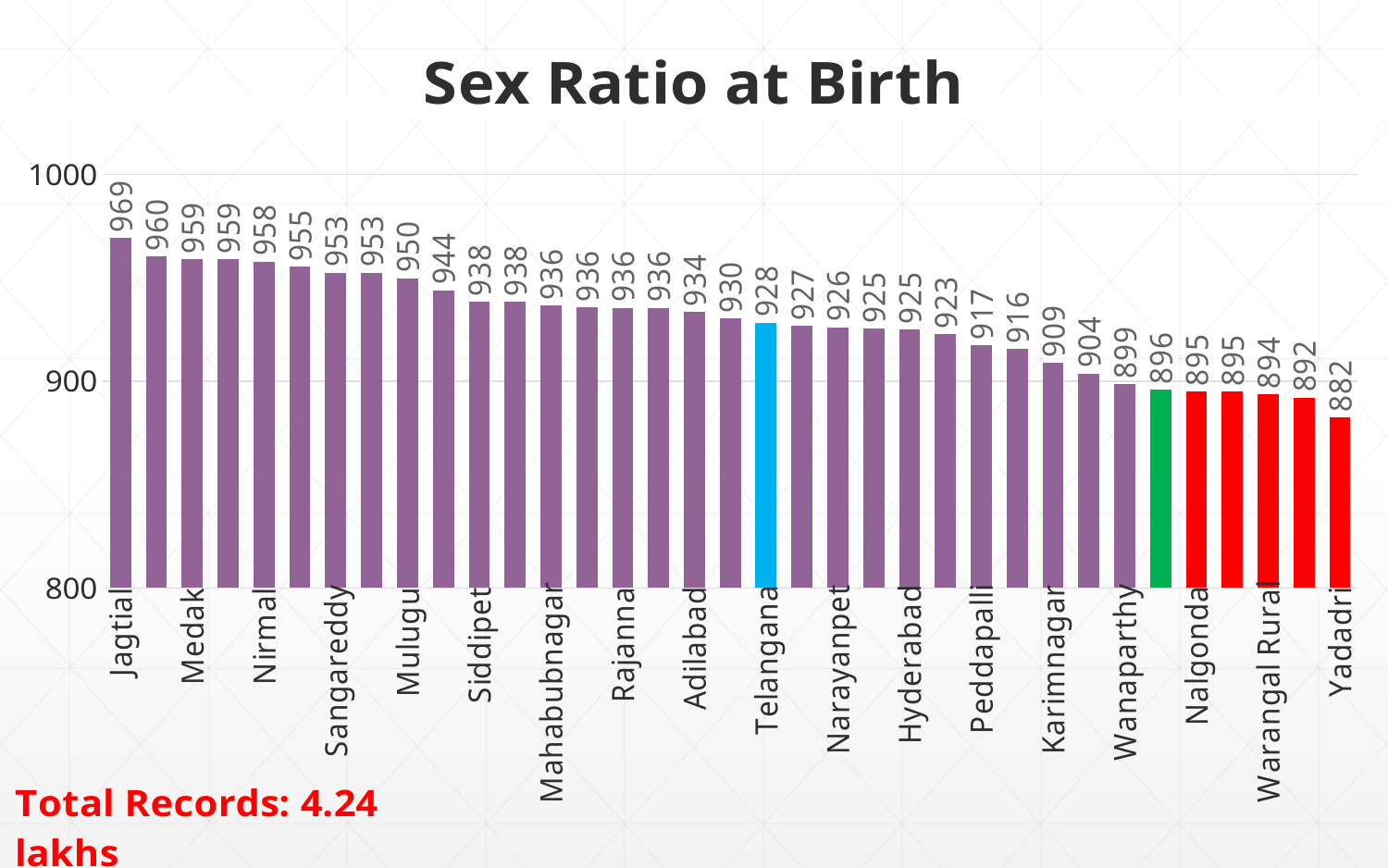
What is the difference between the sex ratio at birth for Jagtial and for Yadadri? 87 What is the sex ratio at birth for Karimnagar? 909 Do the values rise or fall from left to right along the x axis? fall Which labelled district has the lowest sex ratio at birth? Yadadri Is the value for Wanaparthy greater or less than 900? less What is the sex ratio at birth for Yadadri? 882 Which has a higher sex ratio at birth, Medak or Nalgonda? Medak What is the sex ratio at birth for Hyderabad? 925 What is the sex ratio at birth for Jagtial? 969 What is the sex ratio at birth for Telangana? 928 Which labelled district has the highest sex ratio at birth? Jagtial What colour is the bar for Telangana? blue